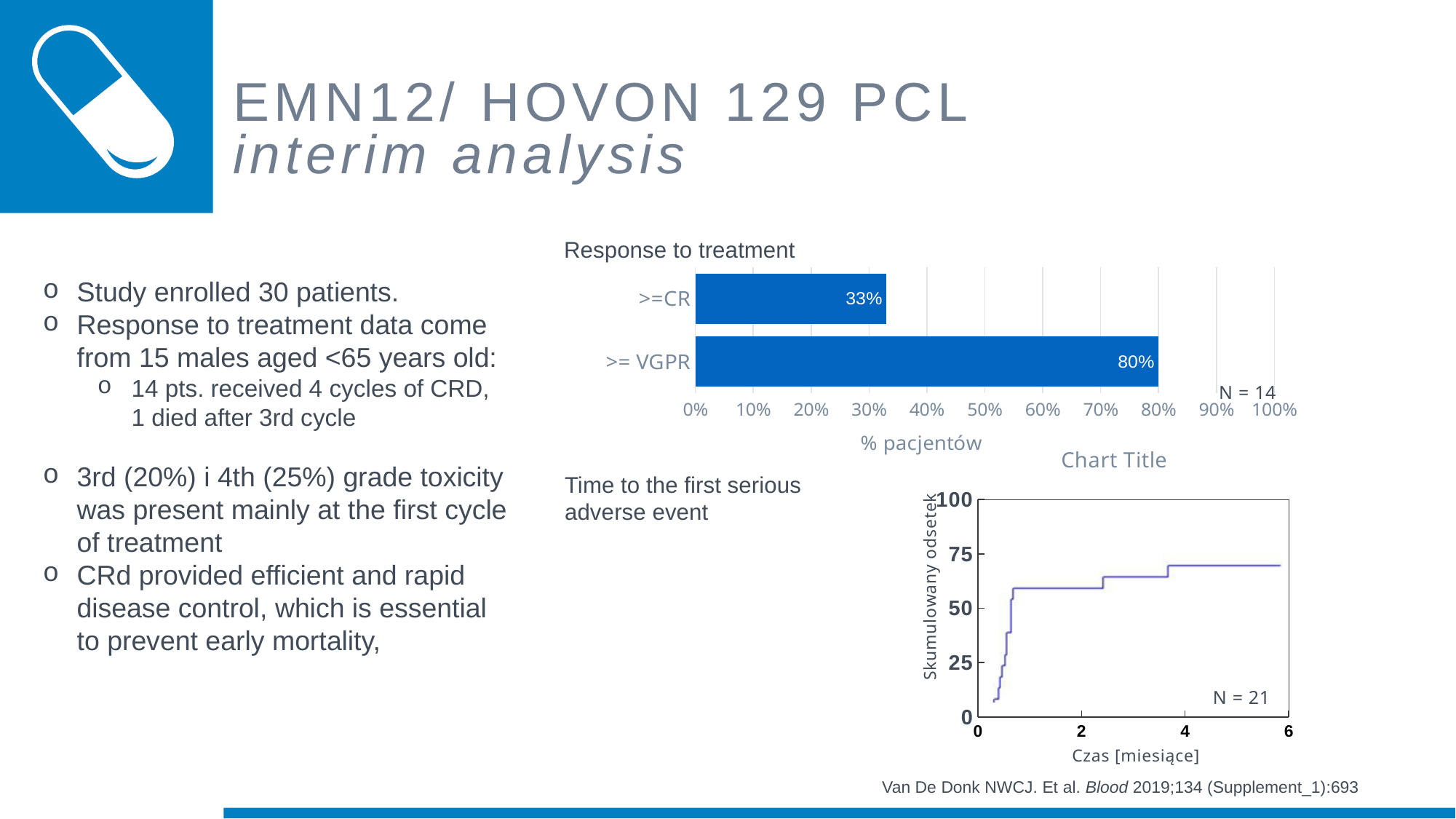
In the 'Response to treatment' chart, what is the difference between the >= VGPR and >=CR values? 47% In the 'Response to treatment' chart, what is the x-axis label? % pacjentów In the 'Response to treatment' chart, how many categories are plotted? 2 In the 'Response to treatment' chart, which is larger, the value for >=CR or for >= VGPR? >= VGPR In the chart titled 'Chart Title' at the bottom right, do the values rise or fall along the x axis? rise In the 'Response to treatment' chart, which category has the highest value? >= VGPR In the 'Response to treatment' chart, what is the value for >= VGPR? 80% In the 'Response to treatment' chart, which category has the lowest value? >=CR In the chart titled 'Chart Title' at the bottom right, is the value at 4 months greater or less than 50? greater What kind of chart is the 'Response to treatment' chart? bar chart In the 'Response to treatment' chart, what is the value for >=CR? 33% In the chart titled 'Chart Title' at the bottom right, what is the x-axis label? Czas [miesiące]